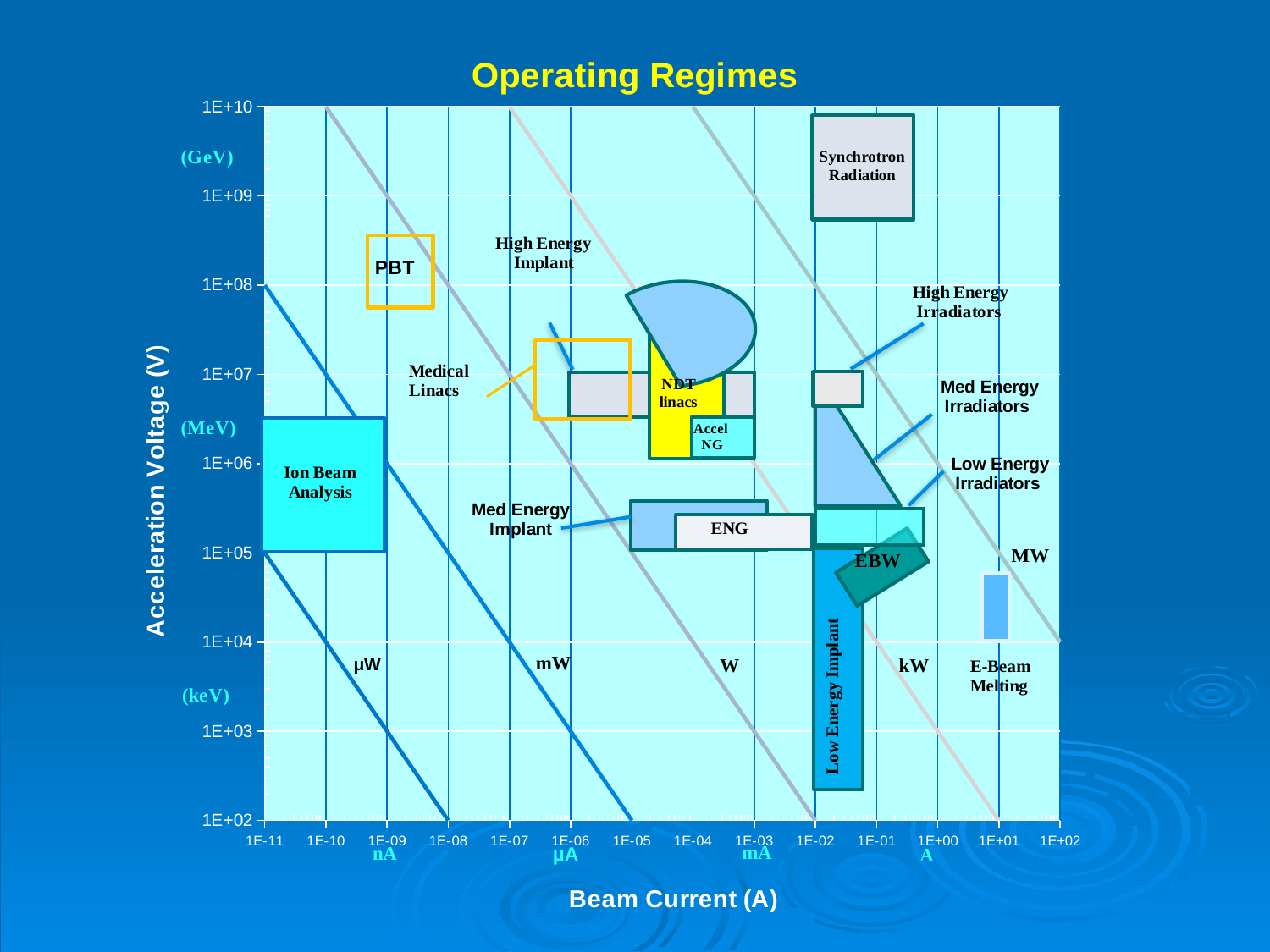
Which labeled operating regime reaches the highest acceleration voltage? Synchrotron Radiation Which operates at a higher beam current, E-Beam Melting or PBT? E-Beam Melting Is the acceleration voltage of the Synchrotron Radiation region greater or less than 1E+08 V? greater What is the label of the x axis? Beam Current (A) Is the beam current of the Ion Beam Analysis region greater or less than 1E-08 A? less Is the acceleration voltage of the Accel NG region greater or less than 1E+05 V? greater Which labeled operating regime extends to the lowest acceleration voltage? Low Energy Implant Which labeled operating regime sits at the lowest beam current? Ion Beam Analysis How many diagonal power lines (µW, mW, W, kW, MW) are labeled on the chart? 5 What is the title of the chart? Operating Regimes Which operates at a higher acceleration voltage, High Energy Implant or Low Energy Implant? High Energy Implant